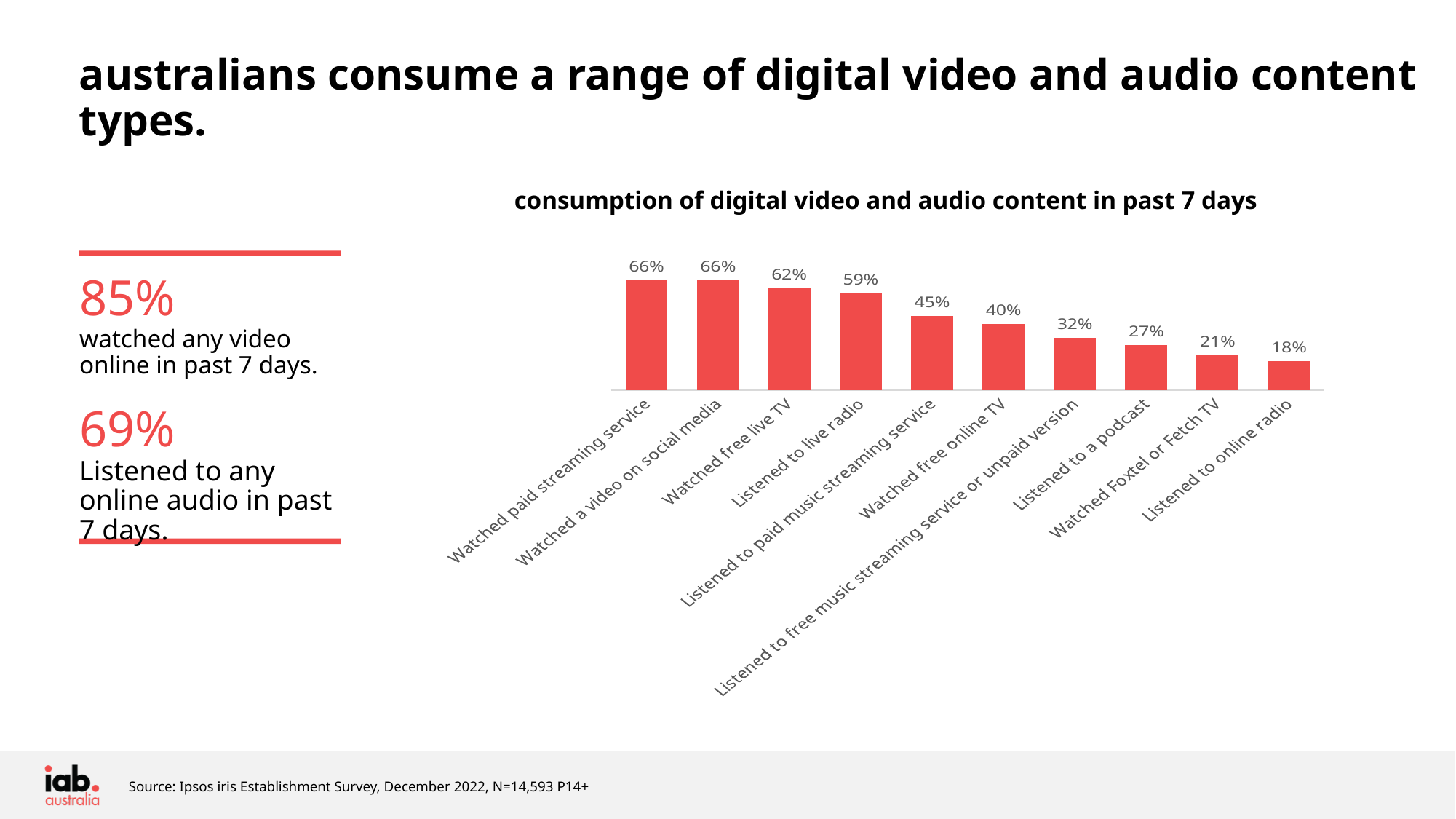
Which is larger: 'Listened to free music streaming service or unpaid version' or 'Listened to a podcast'? Listened to free music streaming service or unpaid version What kind of chart is shown on the slide? Bar chart What is the value for 'Listened to a podcast'? 27% What is the difference between 'Listened to live radio' and 'Listened to paid music streaming service'? 14% What colour are the bars in the chart? Red What is the value for 'Watched free live TV'? 62% What is the value for 'Watched free online TV'? 40% What is the difference between 'Watched Foxtel or Fetch TV' and 'Listened to online radio'? 3% Which category has the lowest value? Listened to online radio What is the title of the chart? consumption of digital video and audio content in past 7 days How many categories are shown in the chart? 10 Do the values rise or fall from left to right along the x axis? Fall